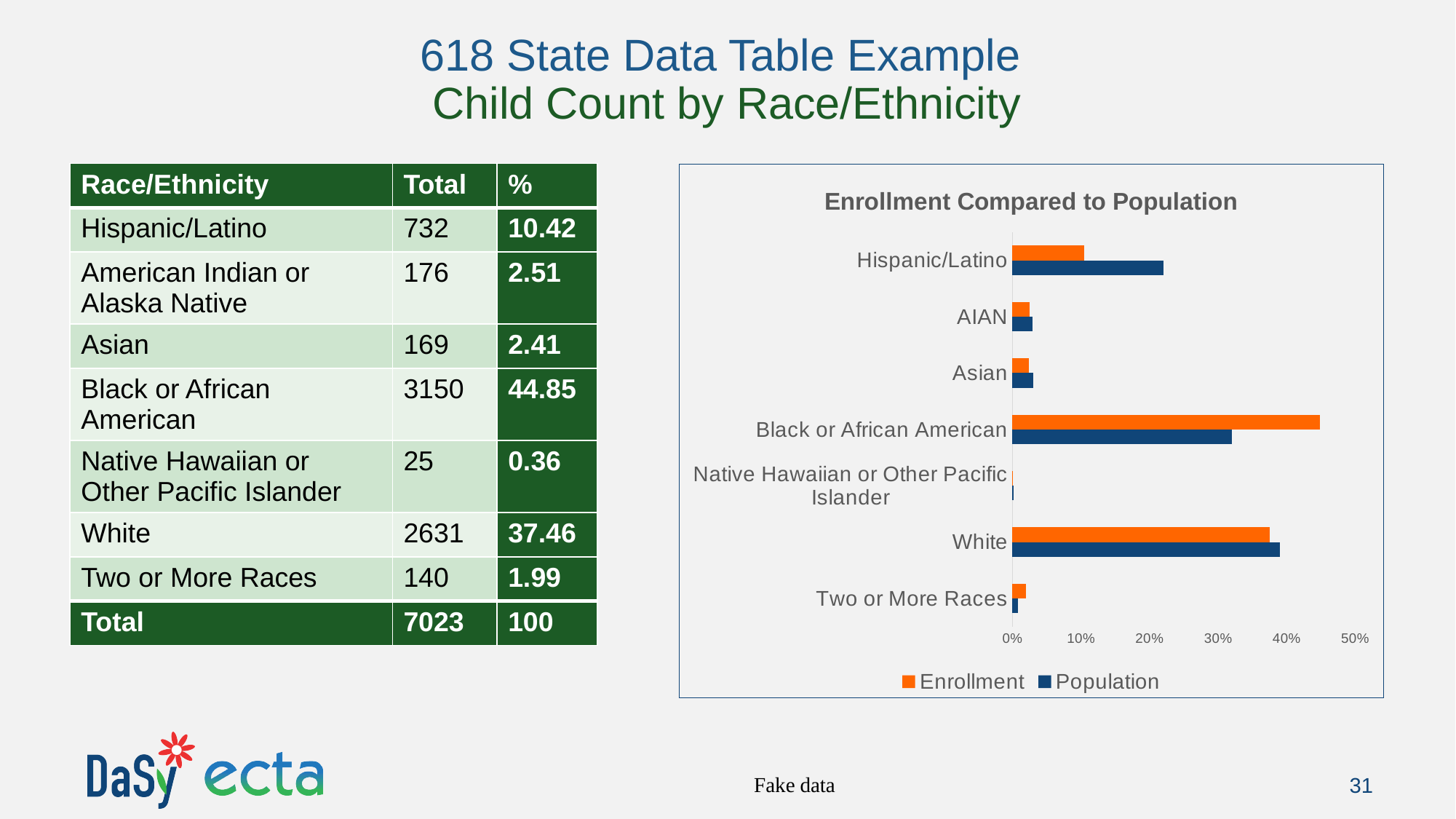
Which colour represents the Enrollment series in the chart? orange What type of chart is shown on the slide? bar chart Which category has the lowest Enrollment value in the chart? Native Hawaiian or Other Pacific Islander For Hispanic/Latino, which is larger in the chart: Enrollment or Population? Population Is the Population value for Hispanic/Latino greater or less than 20%? greater Is the Enrollment value for Black or African American greater or less than 40%? greater For Black or African American, which is larger in the chart: Enrollment or Population? Enrollment How many series does the chart legend list? 2 Which category has the highest Enrollment value in the chart? Black or African American What is the title of the chart? Enrollment Compared to Population Which category has the highest Population value in the chart? White How many race/ethnicity categories are plotted in the chart? 7